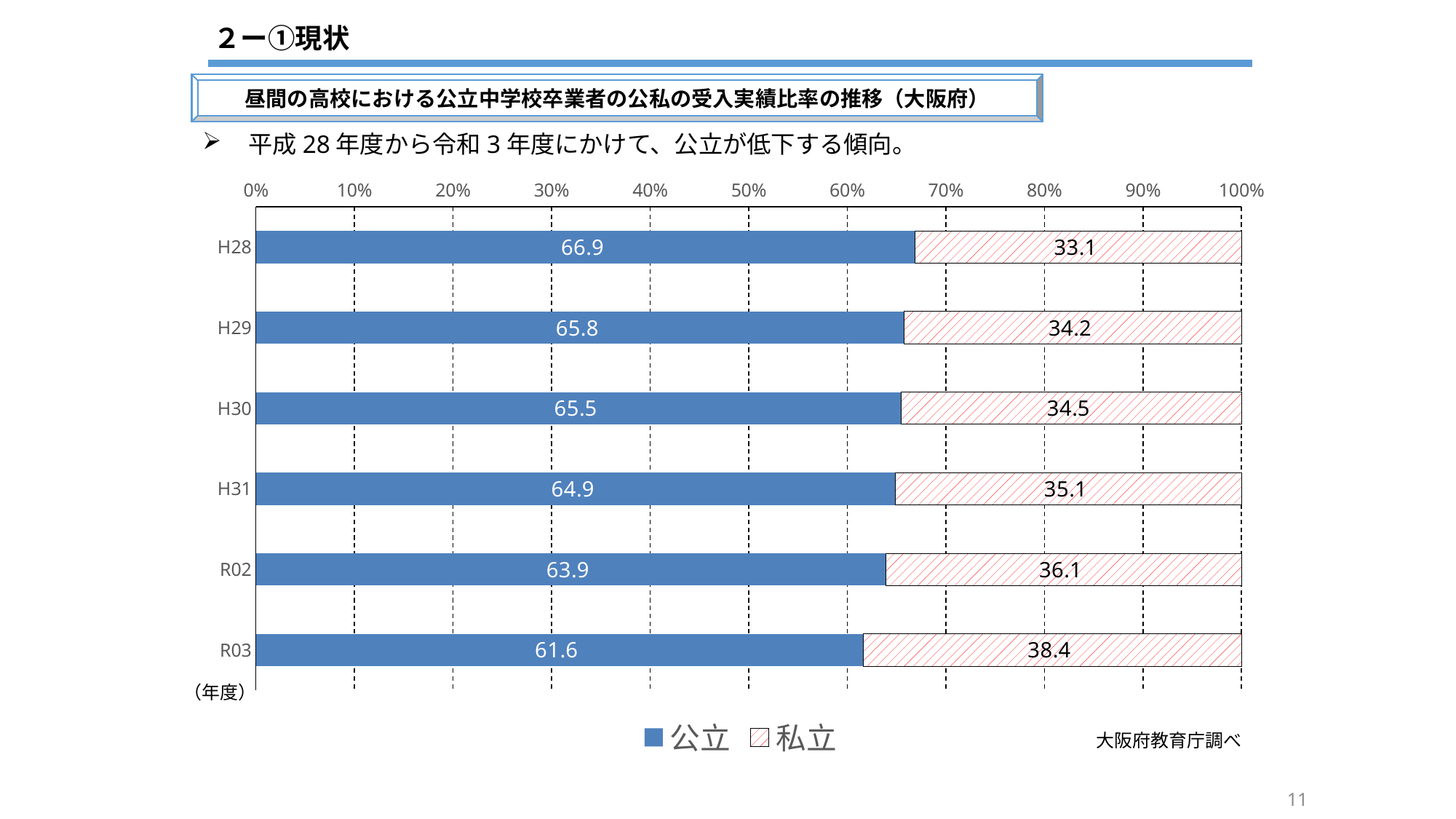
What is the 私立 value for R03? 38.4 How many years are shown on the chart? 6 What is the 私立 value for H30? 34.5 Which is larger, the 私立 value for H29 or for R02? R02 What is the total of the stacked bar for H31? 100 Does the 公立 value rise or fall from H28 to R03? Fall What is the difference between the 公立 values for H28 and R03? 5.3 What is the 公立 value for H28? 66.9 How many series does the legend list? 2 What kind of chart is shown? Stacked bar chart Which year has the highest 公立 value? H28 Which year has the lowest 公立 value? R03